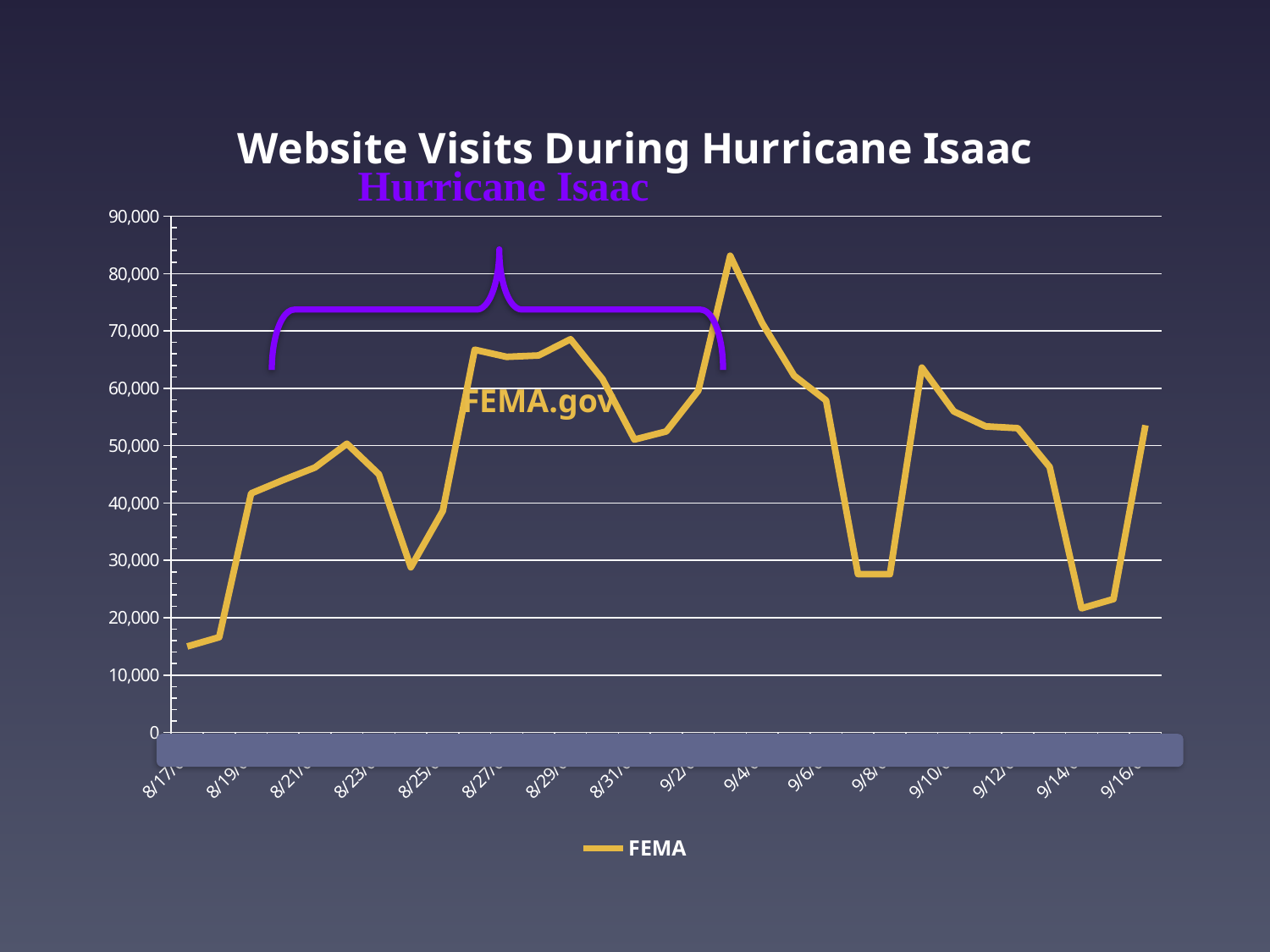
How many series does the legend list? 1 Is the value for 9/16 greater or less than 50,000? greater Which date has the lowest number of website visits? 8/17 Is the value for 8/17 greater or less than 20,000? less What is the name of the series shown in the legend? FEMA What is the title of the chart? Website Visits During Hurricane Isaac Do the values rise or fall from 8/17 to 8/19? rise Is the highest value on the chart greater or less than 80,000? greater Which has the larger value, 8/17 or 9/16? 9/16 How many date labels are shown on the x axis? 16 What kind of chart is shown on the slide? Line chart